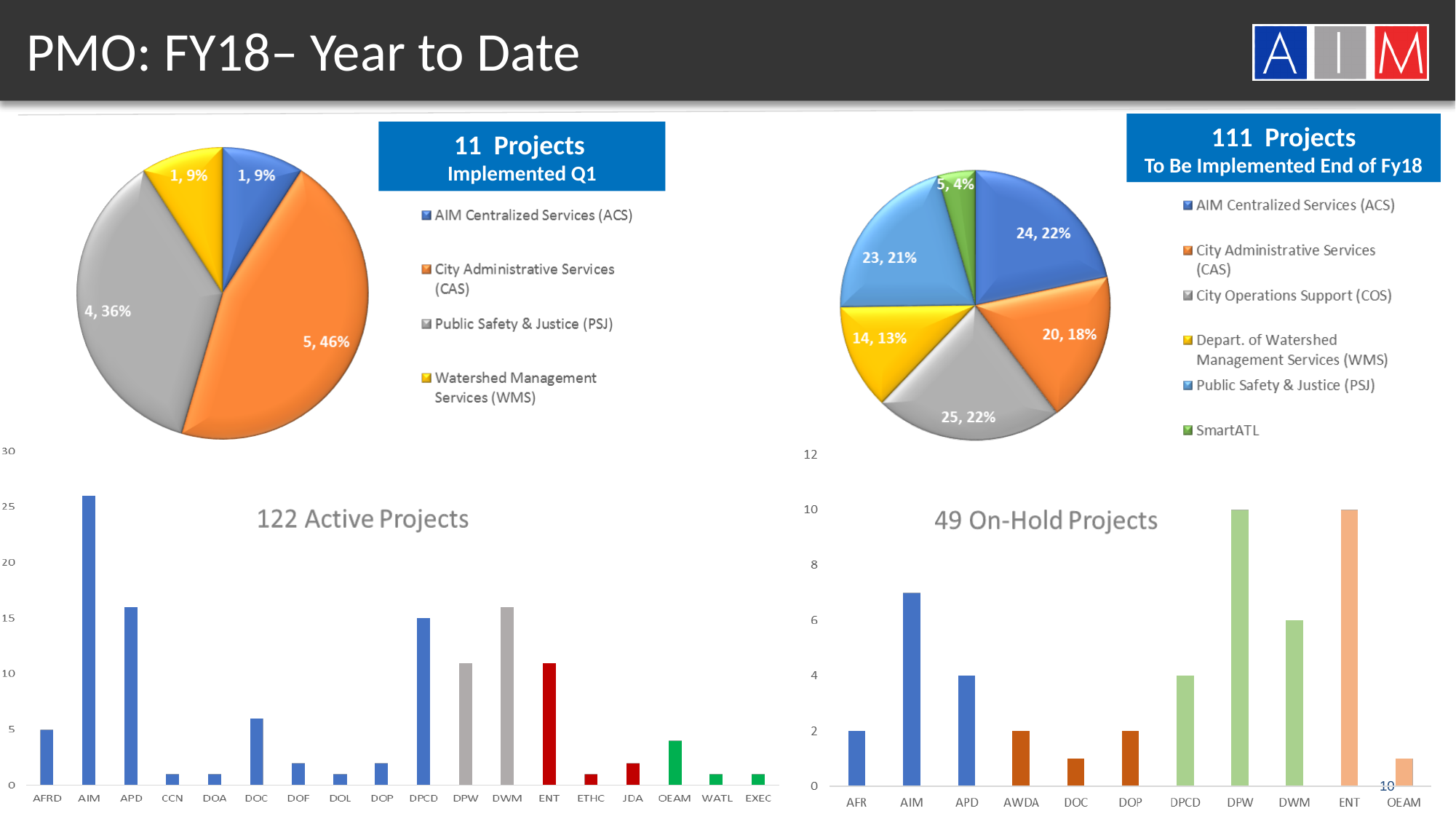
In the '11 Projects Implemented Q1' pie chart, which category has the largest slice? City Administrative Services (CAS) In the '111 Projects To Be Implemented End of Fy18' pie chart, what is the difference between the values for City Operations Support (COS) and City Administrative Services (CAS)? 5 In the '49 On-Hold Projects' chart, what is the value for DWM? 6 In the '122 Active Projects' chart, is the value for DPCD greater or less than 10? greater In the '122 Active Projects' chart, which category has the tallest bar? AIM In the '49 On-Hold Projects' chart, which is larger, the value for AIM or the value for APD? AIM In the '111 Projects To Be Implemented End of Fy18' pie chart, which category has the smallest slice? SmartATL How many legend entries does the '111 Projects To Be Implemented End of Fy18' pie chart list? 6 In the '111 Projects To Be Implemented End of Fy18' pie chart, what share does SmartATL have? 4% In the '111 Projects To Be Implemented End of Fy18' pie chart, what is the value shown for Depart. of Watershed Management Services (WMS)? 14 In the '11 Projects Implemented Q1' pie chart, what is the value and share shown for City Administrative Services (CAS)? 5, 46% How many categories are shown on the x axis of the '122 Active Projects' chart? 18